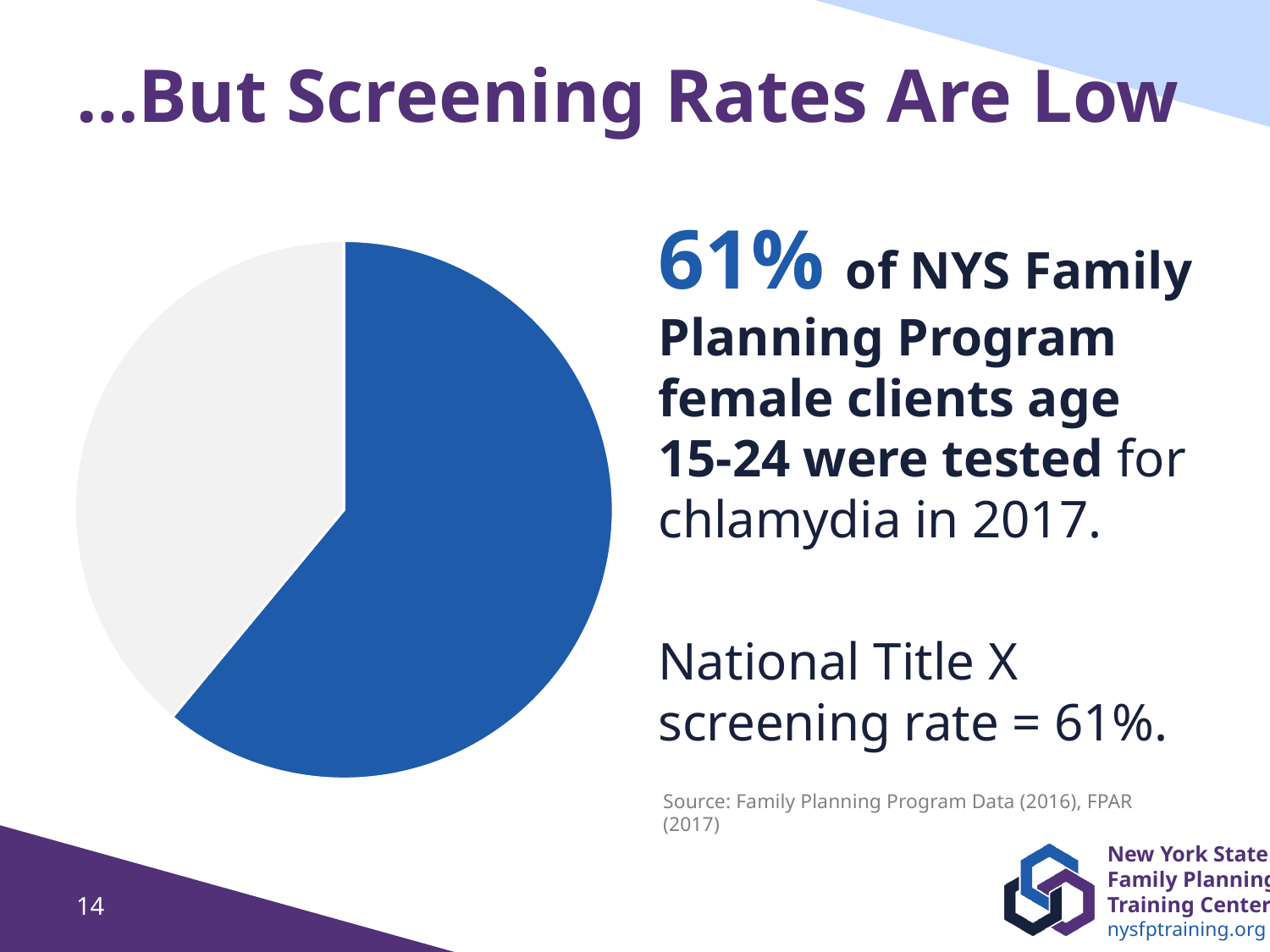
Is the blue slice of the pie chart greater or less than 50% of the pie? greater What kind of chart is shown on the slide? pie chart What colour is the larger slice of the pie chart? blue What is the title of the slide containing the pie chart? ...But Screening Rates Are Low What does the blue slice of the pie chart represent? NYS Family Planning Program female clients age 15-24 tested for chlamydia in 2017 Which slice of the pie chart is larger, the blue slice or the gray slice? the blue slice What is the National Title X screening rate stated on the slide? 61% How many slices does the pie chart have? 2 What share of the pie does the blue slice represent, according to the text on the slide? 61% Is the gray slice of the pie chart greater or less than 50% of the pie? less